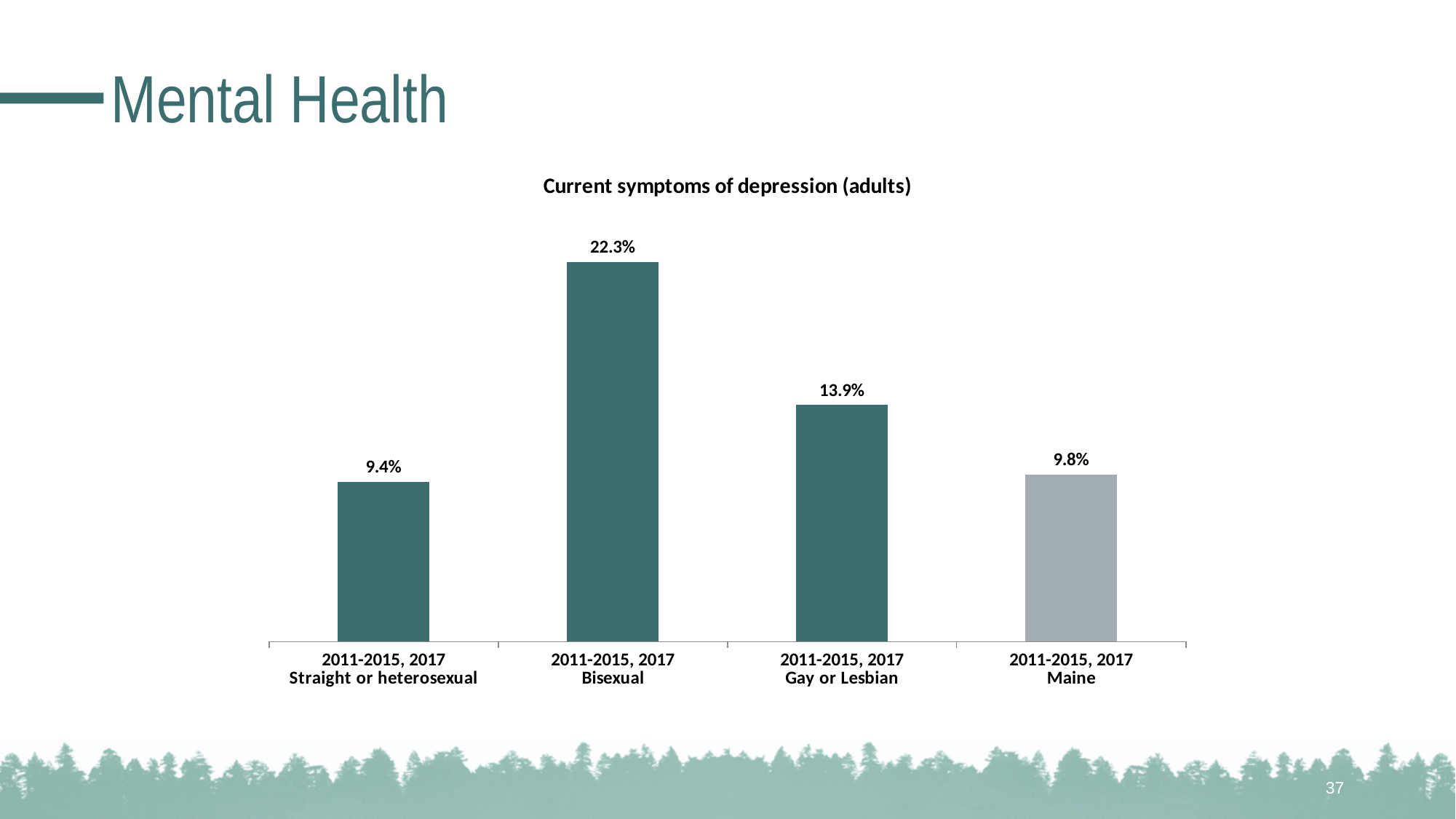
Which is larger, the value for Gay or Lesbian or the value for Maine? Gay or Lesbian What is the value for Bisexual adults in the chart? 22.3% What kind of chart is shown on the slide? Bar chart What is the difference between the Maine value and the Straight or heterosexual value? 0.4% What is the value for Gay or Lesbian adults? 13.9% What is the value for Maine overall? 9.8% How many categories are shown in the chart? 4 What is the difference between the Bisexual value and the Gay or Lesbian value? 8.4% What is the title of the chart? Current symptoms of depression (adults) Which category has the lowest percentage of current symptoms of depression? Straight or heterosexual What is the value for Straight or heterosexual adults? 9.4% Which category has the highest percentage of current symptoms of depression? Bisexual